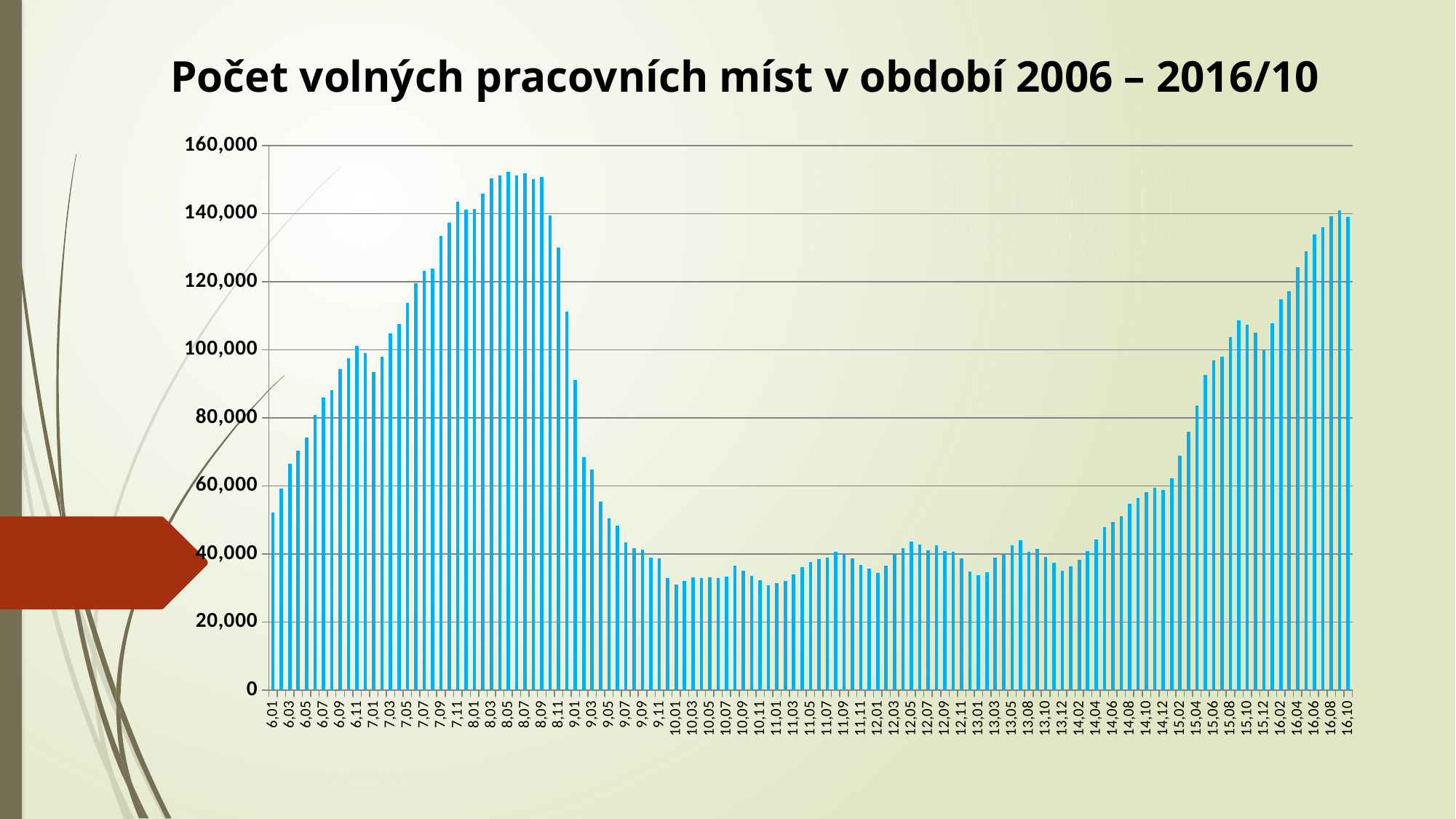
Do the values rise or fall from 9,01 to 10,01? fall What is the highest value shown on the vertical axis? 160,000 Is the value for 15,06 greater or less than 80,000? greater What is the title of the chart? Počet volných pracovních míst v období 2006 – 2016/10 Is the value for 9,01 greater or less than 80,000? greater Is the value for 10,01 greater or less than 40,000? less Do the values rise or fall from 14,02 to 16,08? rise Which has the larger value, 8,05 or 16,10? 8,05 What kind of chart is shown on the slide? bar chart